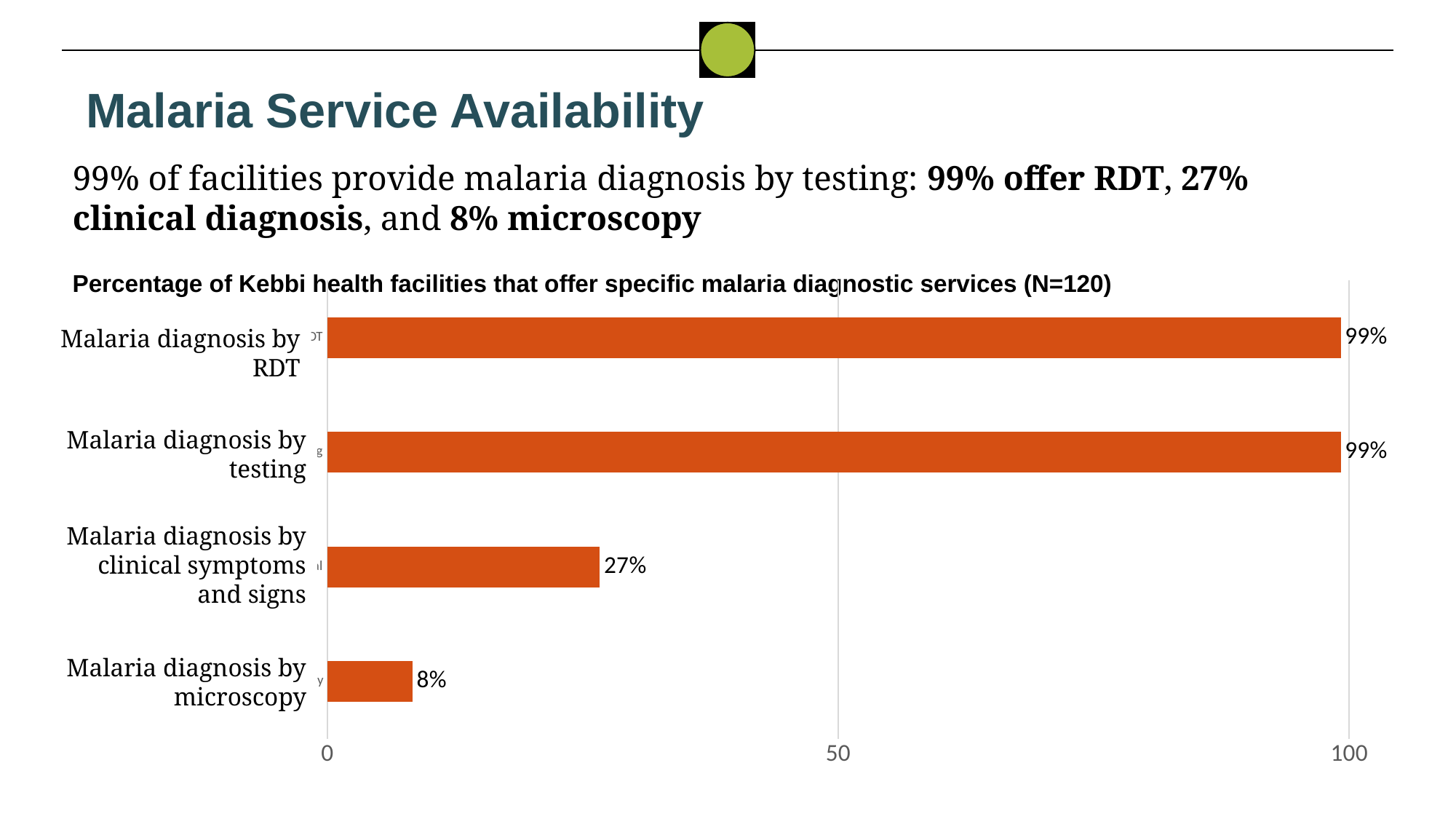
Which is larger: the percentage for malaria diagnosis by clinical symptoms and signs or for malaria diagnosis by microscopy? Malaria diagnosis by clinical symptoms and signs Which diagnostic service has the lowest percentage of facilities offering it? Malaria diagnosis by microscopy What percentage of facilities offer malaria diagnosis by microscopy? 8% What percentage of facilities offer malaria diagnosis by clinical symptoms and signs? 27% What is the sample size (N) stated in the chart title? 120 Is the value for malaria diagnosis by clinical symptoms and signs greater or less than 50? less How many diagnostic service categories are shown in the chart? 4 What percentage of facilities offer malaria diagnosis by RDT? 99% What is the difference in percentage points between malaria diagnosis by RDT and malaria diagnosis by clinical symptoms and signs? 72 What kind of chart is shown on the slide? Bar chart What is the difference in percentage points between malaria diagnosis by clinical symptoms and signs and malaria diagnosis by microscopy? 19 What percentage of facilities offer malaria diagnosis by testing? 99%